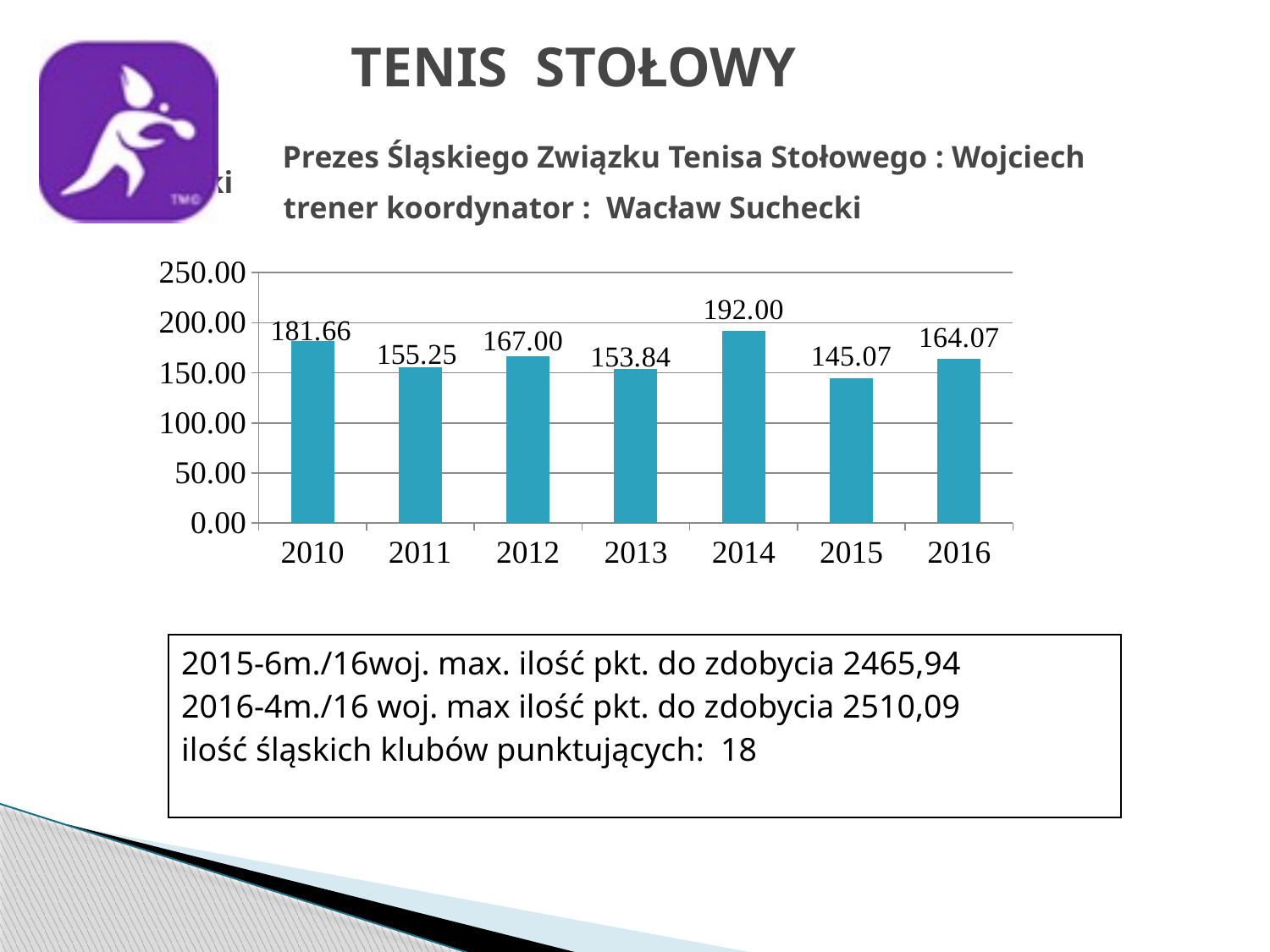
Which is larger, the value for 2012 or the value for 2013? 2012 What is the difference between the values for 2014 and 2015? 46.93 What kind of chart is shown on the slide? bar chart Is the value for 2015 greater or less than 150.00? less What is the value for 2010? 181.66 Which year has the lowest value? 2015 What is the value for 2014? 192.00 What is the highest value shown on the y axis? 250.00 Does the value rise or fall from 2014 to 2015? fall How many years are shown on the x axis? 7 What is the value for 2016? 164.07 Which year has the highest value? 2014